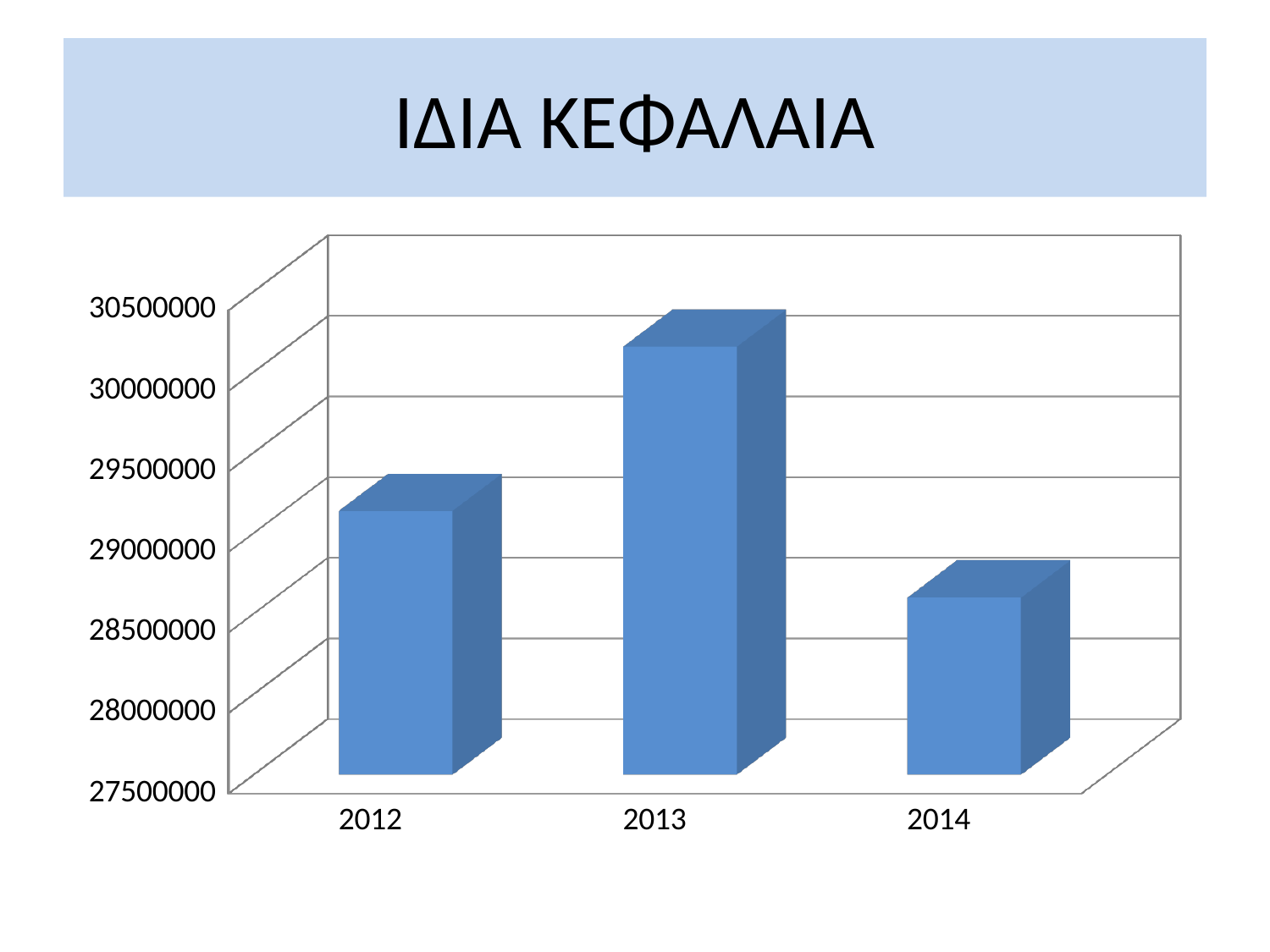
Is the value for 2013 greater or less than 30000000? greater Is the value for 2014 greater or less than 29000000? less Which year has the lowest value in the chart? 2014 Which year has the highest value in the chart? 2013 Do the values rise or fall from 2013 to 2014? fall Is the value for 2012 greater or less than 29500000? less How many years are shown on the x axis of the chart? 3 What colour are the bars in the chart? Blue Which is larger, the value for 2012 or the value for 2014? 2012 What kind of chart is shown on the slide? Bar chart What is the title of the chart on the slide? ΙΔΙΑ ΚΕΦΑΛΑΙΑ